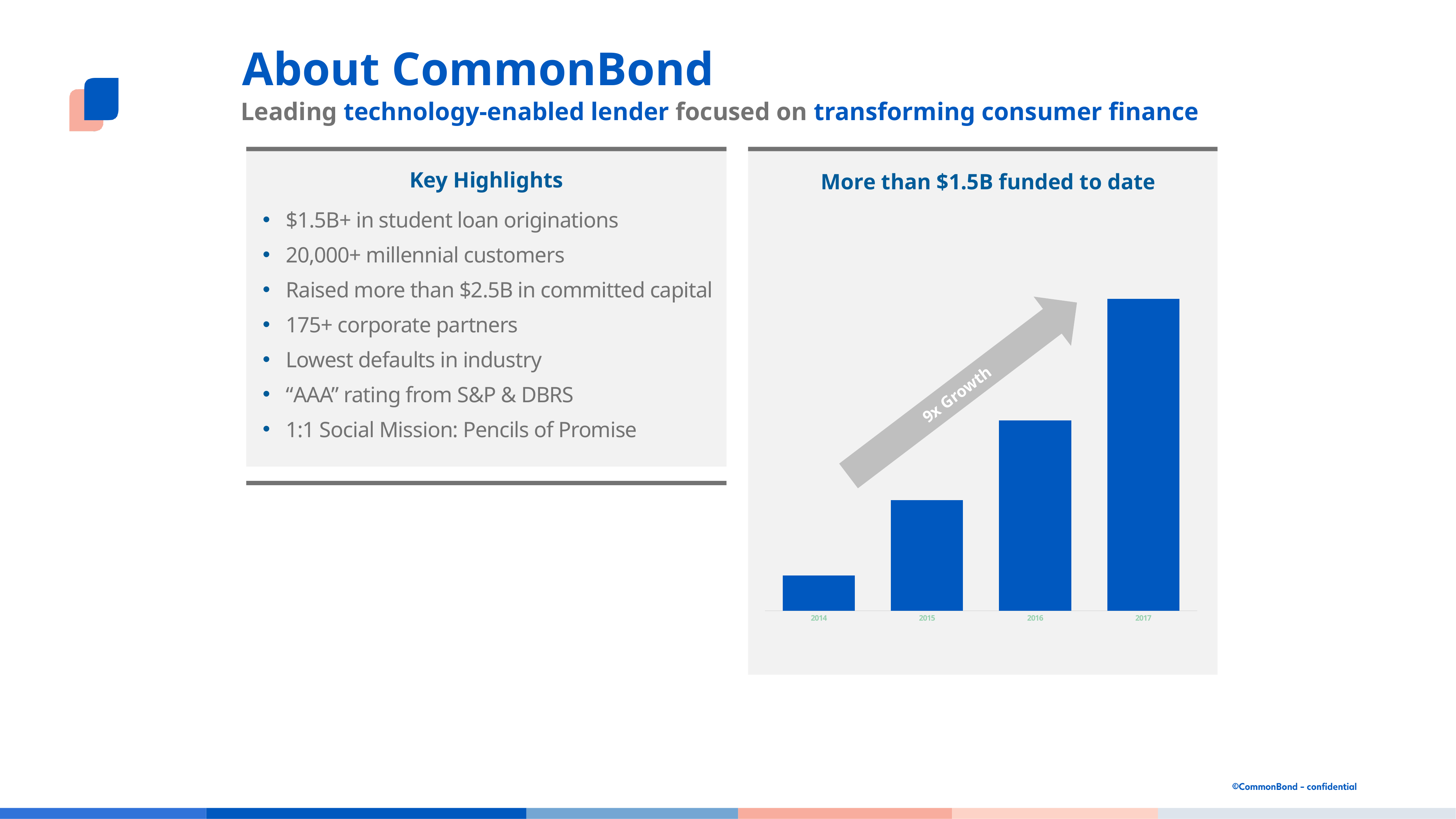
How many years are shown on the x axis of the chart? 4 Which bar is taller in the chart, 2015 or 2016? 2016 What text is written on the grey arrow in the chart? 9x Growth What is the first year shown on the x axis of the chart? 2014 Which year has the shortest bar in the chart? 2014 Which bar is taller in the chart, 2016 or 2017? 2017 Which bar is taller in the chart, 2014 or 2015? 2015 Which year has the tallest bar in the chart? 2017 What is the title of the chart? More than $1.5B funded to date What kind of chart is shown on the slide? bar chart Do the bar values rise or fall from 2014 to 2017 in the chart? rise